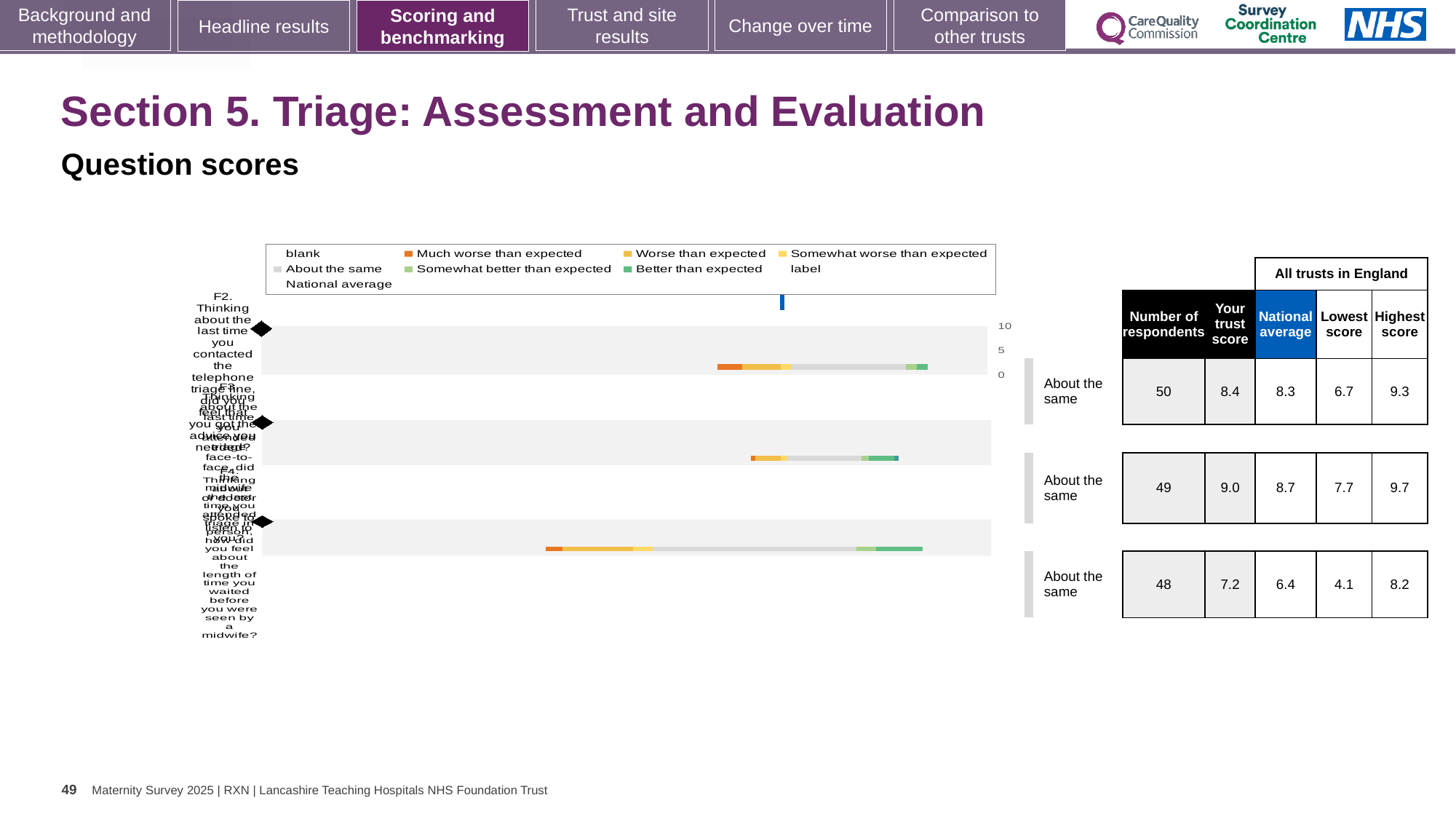
In the table beside the chart, what is the national average for the third question (F4)? 6.4 In the table beside the chart, what is the difference between the trust score and the national average for the third question (F4)? 0.8 What kind of chart is shown on the slide? bar chart How many entries does the chart legend list? 9 In the table beside the chart, which question has the lowest 'Lowest score' across all trusts in England? F4 (4.1) In the table beside the chart, what is the number of respondents for the first question (F2)? 50 What benchmark category is shown next to each of the three question bars? About the same In the table beside the chart, which question has the highest trust score? F3 (9.0) How many question bars are plotted in the chart? 3 In the table beside the chart, what is the trust score for the second question (F3)? 9.0 In the table beside the chart, is the trust score for the first question (F2) larger or smaller than its national average? larger What is the maximum value shown on the chart's numeric axis? 10